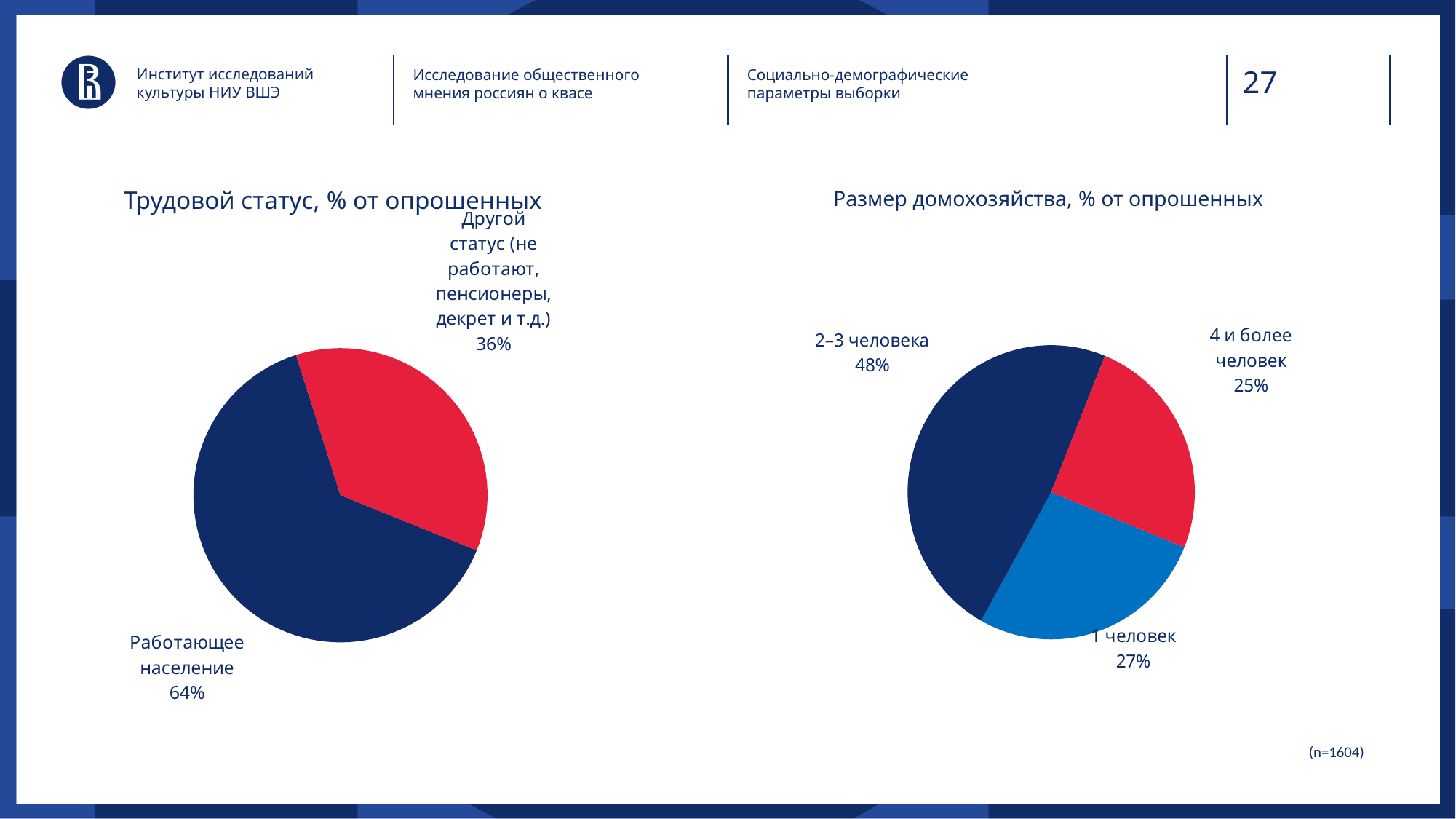
In the chart titled "Размер домохозяйства, % от опрошенных", how many slices does the pie have? 3 In the chart titled "Размер домохозяйства, % от опрошенных", what is the value for "2–3 человека"? 48% What kind of chart is the chart titled "Трудовой статус, % от опрошенных"? Pie chart In the chart titled "Трудовой статус, % от опрошенных", how many slices does the pie have? 2 In the chart titled "Трудовой статус, % от опрошенных", what is the difference between "Работающее население" and "Другой статус"? 28% In the chart titled "Трудовой статус, % от опрошенных", which category has the largest share? Работающее население In the chart titled "Размер домохозяйства, % от опрошенных", what is the difference between "2–3 человека" and "1 человек"? 21% In the chart titled "Трудовой статус, % от опрошенных", what is the value for "Другой статус (не работают, пенсионеры, декрет и т.д.)"? 36% In the chart titled "Размер домохозяйства, % от опрошенных", which category has the smallest share? 4 и более человек In the chart titled "Размер домохозяйства, % от опрошенных", what is the value for "4 и более человек"? 25% In the chart titled "Размер домохозяйства, % от опрошенных", what is the value for "1 человек"? 27% In the chart titled "Трудовой статус, % от опрошенных", what is the value for "Работающее население"? 64%